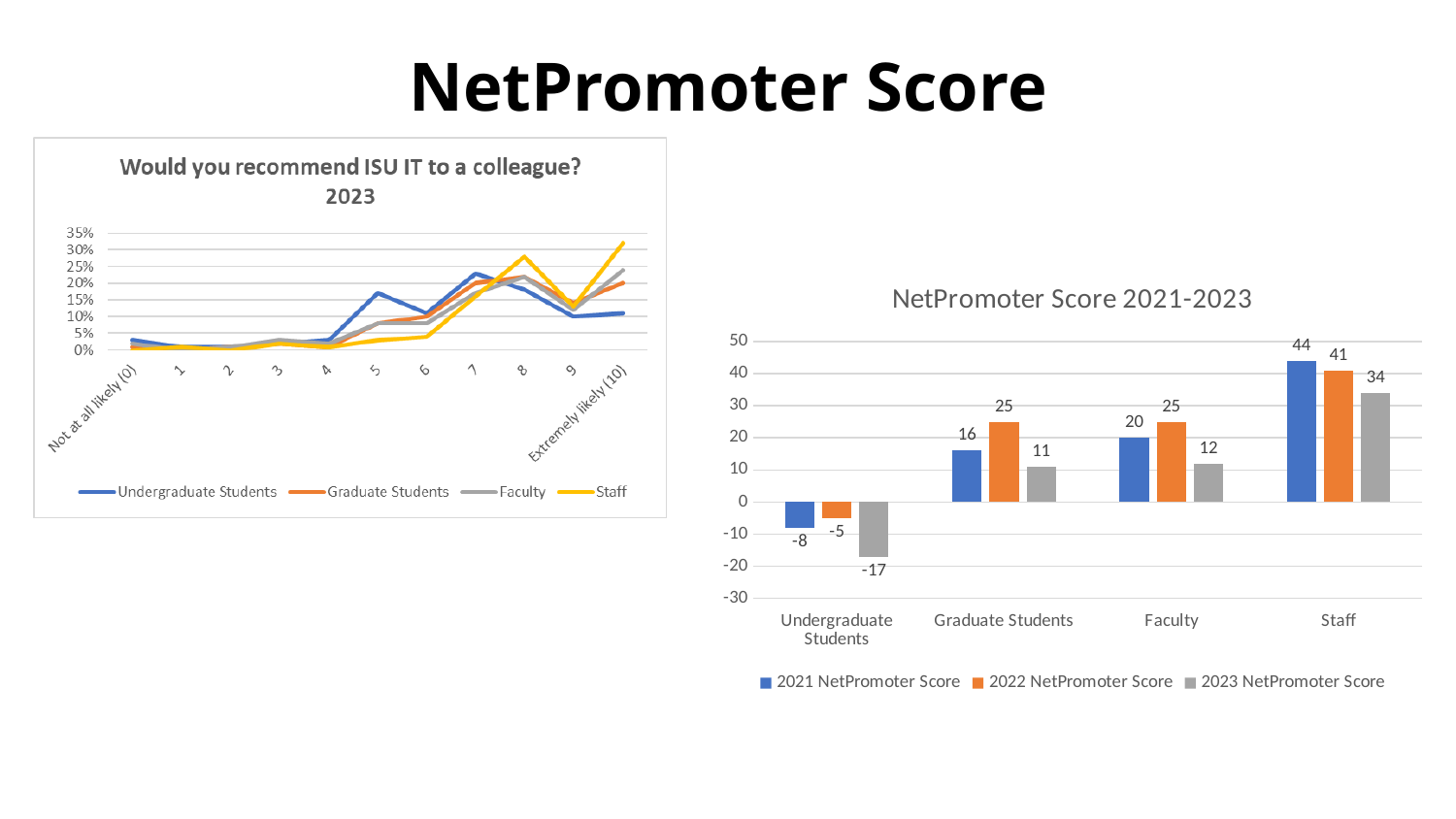
In the 'NetPromoter Score 2021-2023' chart, how many series does the legend list? 3 In the 'NetPromoter Score 2021-2023' chart, what is the 2021 NetPromoter Score for Undergraduate Students? -8 In the 'NetPromoter Score 2021-2023' chart, which category has the highest 2021 NetPromoter Score? Staff In the 'Would you recommend ISU IT to a colleague? 2023' chart, how many series does the legend list? 4 What kind of chart is the 'Would you recommend ISU IT to a colleague? 2023' chart? Line chart In the 'NetPromoter Score 2021-2023' chart, which is larger: the 2022 score for Graduate Students or the 2022 score for Staff? 2022 score for Staff In the 'Would you recommend ISU IT to a colleague? 2023' chart, is the Staff value at 'Extremely likely (10)' greater or less than 30%? greater In the 'NetPromoter Score 2021-2023' chart, what is the 2023 NetPromoter Score for Staff? 34 In the 'NetPromoter Score 2021-2023' chart, how many categories are shown on the x axis? 4 In the 'NetPromoter Score 2021-2023' chart, which category has the lowest 2023 NetPromoter Score? Undergraduate Students In the 'NetPromoter Score 2021-2023' chart, what is the 2022 NetPromoter Score for Faculty? 25 In the 'NetPromoter Score 2021-2023' chart, what is the difference between the 2021 and 2023 NetPromoter Scores for Staff? 10